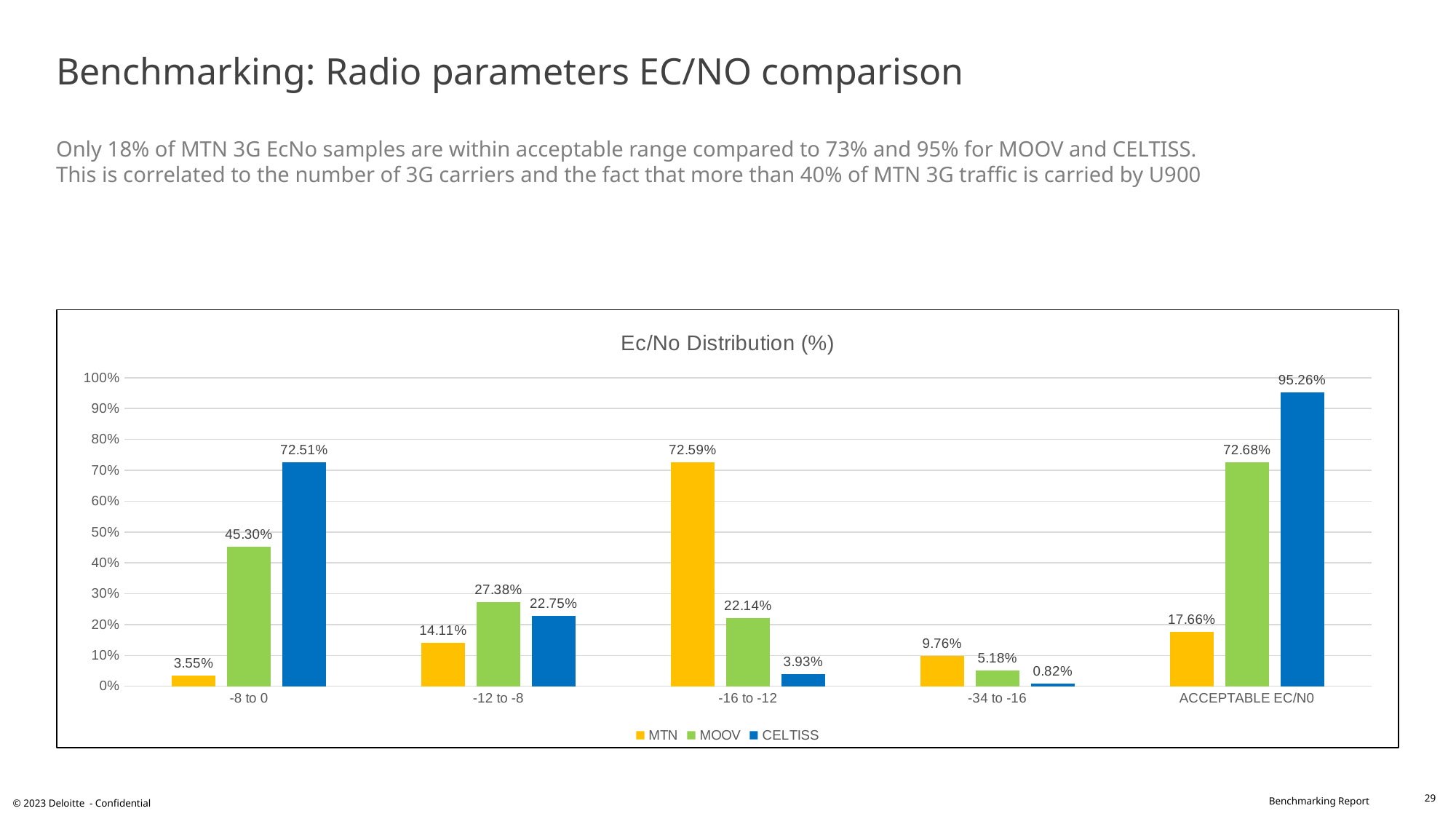
Which is larger in the -16 to -12 category: the MOOV value or the CELTISS value? MOOV What is the value for MOOV in the -8 to 0 category? 45.30% What is the value for MTN in the -16 to -12 category? 72.59% Which series has the highest value in the -12 to -8 category? MOOV Which series has the lowest value in the -34 to -16 category? CELTISS How many series does the legend list? 3 What kind of chart is shown on the slide? Bar chart Which colour represents MTN in the chart? Yellow What is the difference between the CELTISS and MTN values in the ACCEPTABLE EC/N0 category? 77.60% What is the title of the chart? Ec/No Distribution (%) What is the value for CELTISS in the ACCEPTABLE EC/N0 category? 95.26% How many categories are shown on the x axis? 5